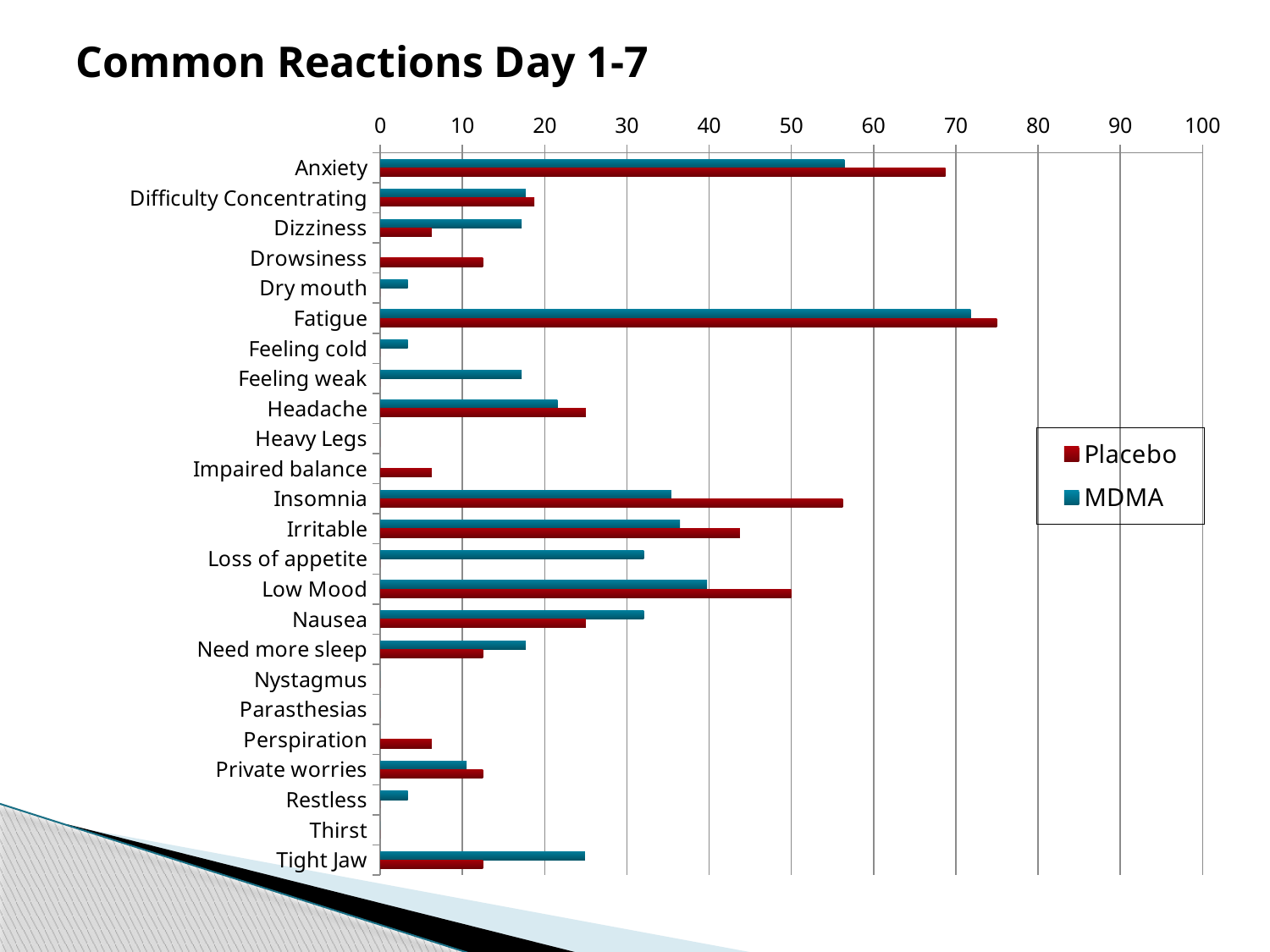
How many series does the legend list? 2 Which reaction has the highest Placebo value? Fatigue For Tight Jaw, which series has the larger value, Placebo or MDMA? MDMA What kind of chart is shown on the slide? bar chart Which series is shown in dark red in the legend? Placebo Which reaction has the highest MDMA value? Fatigue For Anxiety, which series has the larger value, Placebo or MDMA? Placebo What is the title of the chart? Common Reactions Day 1-7 How many reaction categories are plotted on the chart? 24 Is the MDMA value for Nausea greater or less than 30? greater Is the Placebo value for Drowsiness greater or less than 20? less Is the Placebo value for Insomnia greater or less than 50? greater